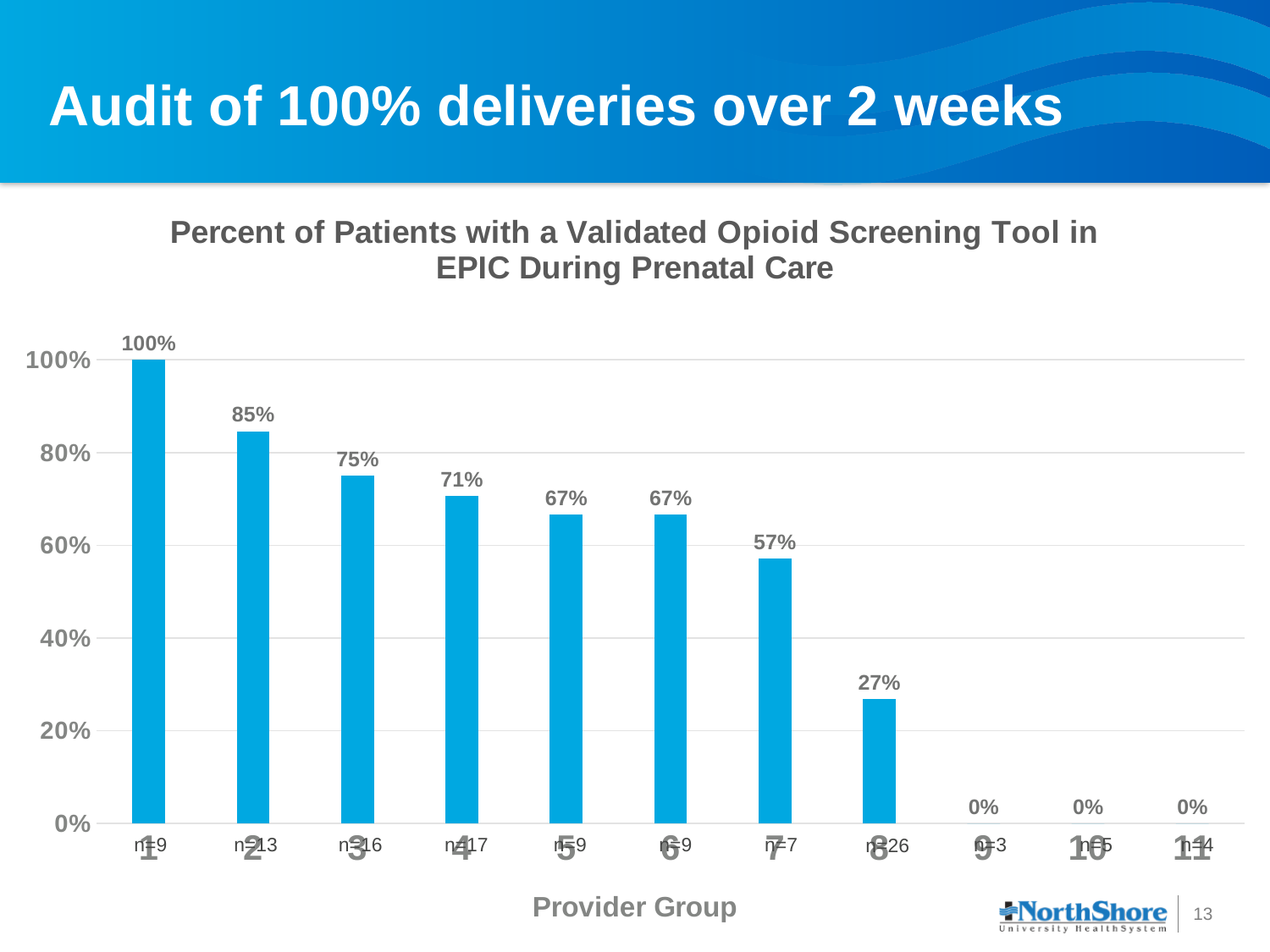
What is the value for Provider Group 1? 100% Do the values rise or fall from Provider Group 1 to Provider Group 11? fall How many provider groups have a value of 0%? 3 What is the value for Provider Group 4? 71% Which is larger, the value for Provider Group 3 or Provider Group 5? Provider Group 3 What is the title of the chart? Percent of Patients with a Validated Opioid Screening Tool in EPIC During Prenatal Care What kind of chart is shown on the slide? bar chart What is the difference between the values for Provider Group 2 and Provider Group 7? 28% Is the value for Provider Group 7 greater or less than 60%? less How many provider groups are shown on the x axis? 11 What is the value for Provider Group 8? 27% Which provider group has the highest percentage? 1